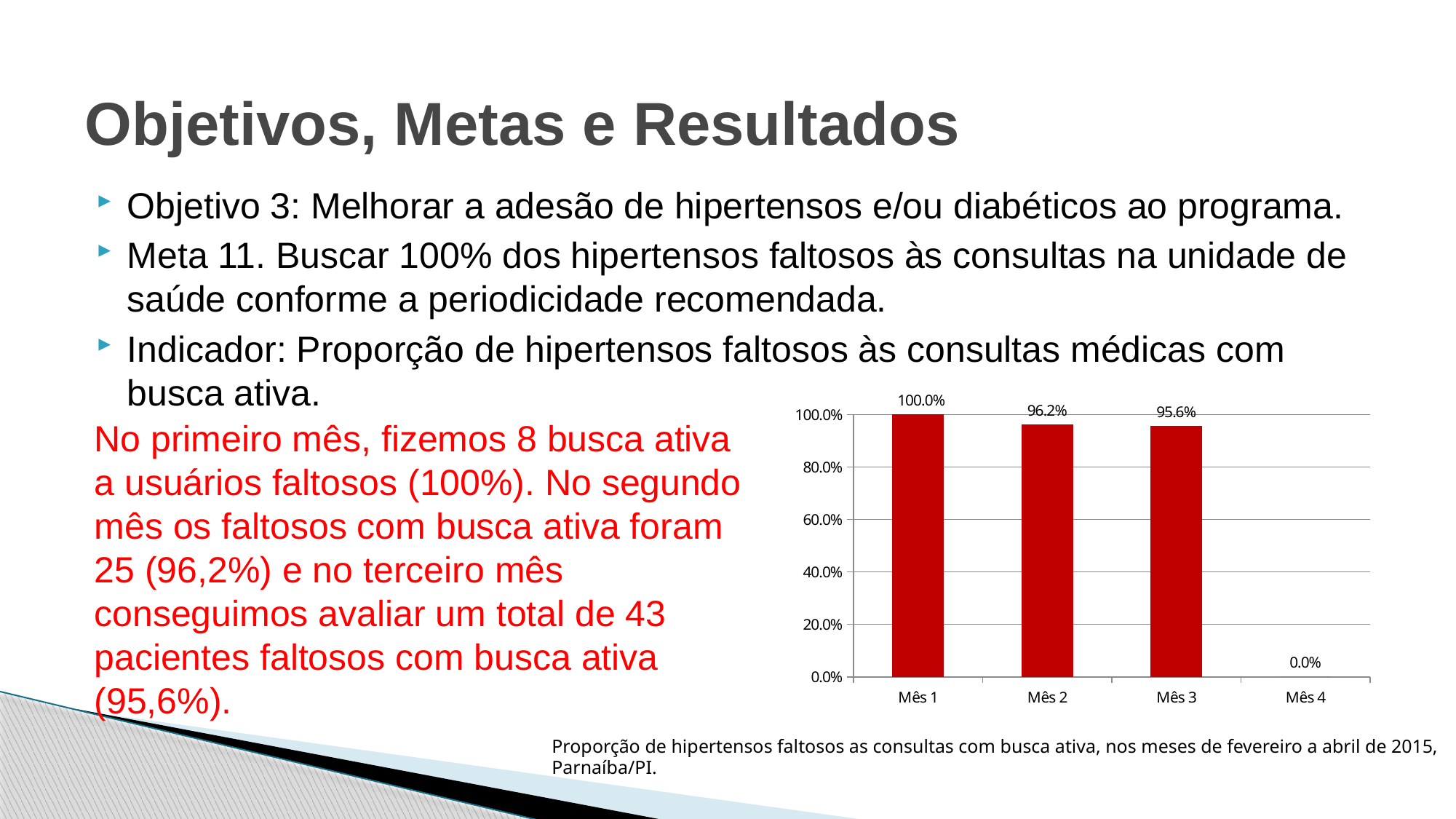
Which month has the lowest value? Mês 4 Which month has the highest value? Mês 1 What is the difference between the values for Mês 2 and Mês 3? 0.6% What kind of chart is shown on the slide? Bar chart What colour are the bars in the chart? Red How many categories are shown on the x axis of the chart? 4 Which is larger, the value for Mês 1 or the value for Mês 3? Mês 1 What is the value for Mês 1? 100.0% What is the difference between the values for Mês 1 and Mês 2? 3.8% What is the value for Mês 3? 95.6% What is the value for Mês 2? 96.2% What is the value for Mês 4? 0.0%